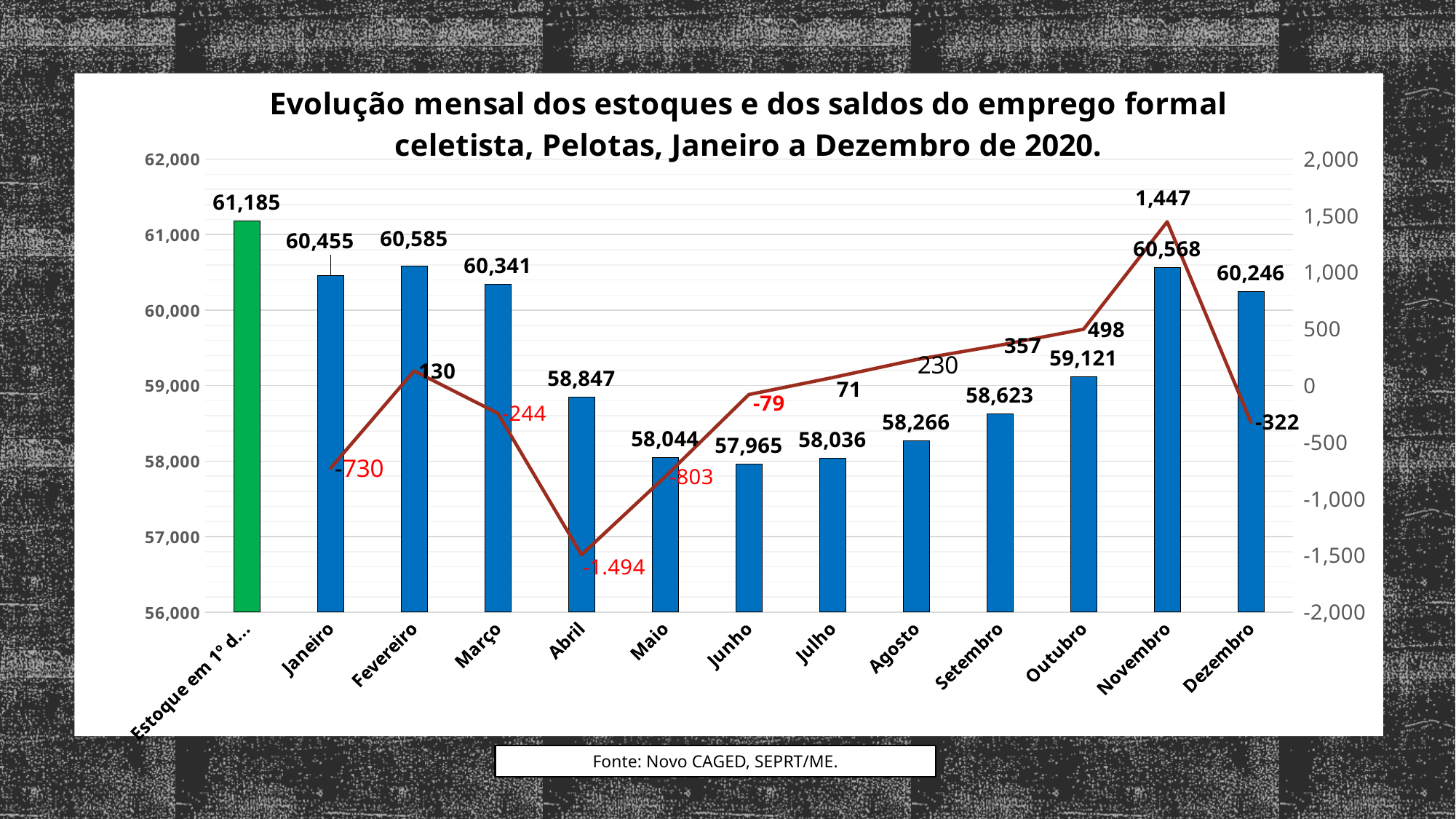
What is the balance (line) value for Abril? -1.494 Is the stock bar for Dezembro greater or less than 60,000? greater What kind of chart is shown on the slide? Combined bar and line chart Do the stock bars rise or fall from Junho to Novembro? rise How many bars are plotted in the chart? 13 What colour is the first bar (Estoque em 1º d...)? Green Which month has the highest balance value on the line? Novembro What is the stock (bar) value for Abril? 58,847 Which is larger, the stock bar for Outubro or for Setembro? Outubro Which month has the lowest stock bar? Junho What is the balance (line) value for Novembro? 1,447 What is the difference between the stock values for Fevereiro and Março? 244